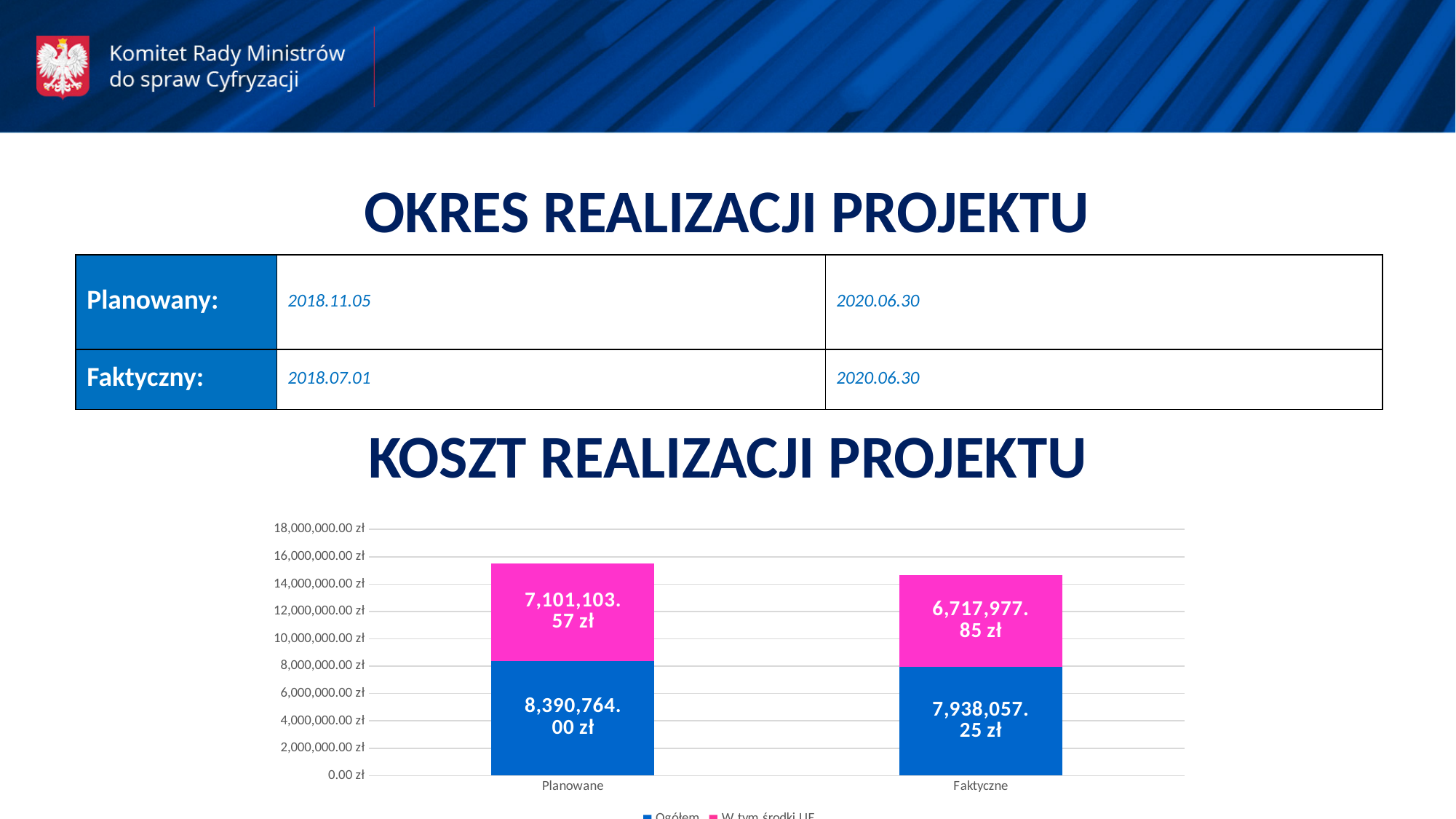
Which category has the higher Ogółem (blue) value, Planowane or Faktyczne? Planowane What is the difference between the blue segment values for Planowane and Faktyczne? 452,706.75 zł What is the total of the stacked bar for Planowane? 15,491,867.57 zł What kind of chart is shown under 'KOSZT REALIZACJI PROJEKTU'? Stacked bar chart How many categories are shown on the x axis of the cost chart? 2 What is the value of the blue segment for Faktyczne? 7,938,057.25 zł What is the total of the stacked bar for Faktyczne? 14,656,035.10 zł How many series does the legend of the cost chart list? 2 What is the value of the pink (W tym środki UE) segment for Faktyczne? 6,717,977.85 zł What is the value of the blue (Ogółem) segment for Planowane? 8,390,764.00 zł What is the value of the pink segment for Planowane? 7,101,103.57 zł What colour represents the 'W tym środki UE' series in the cost chart? Pink